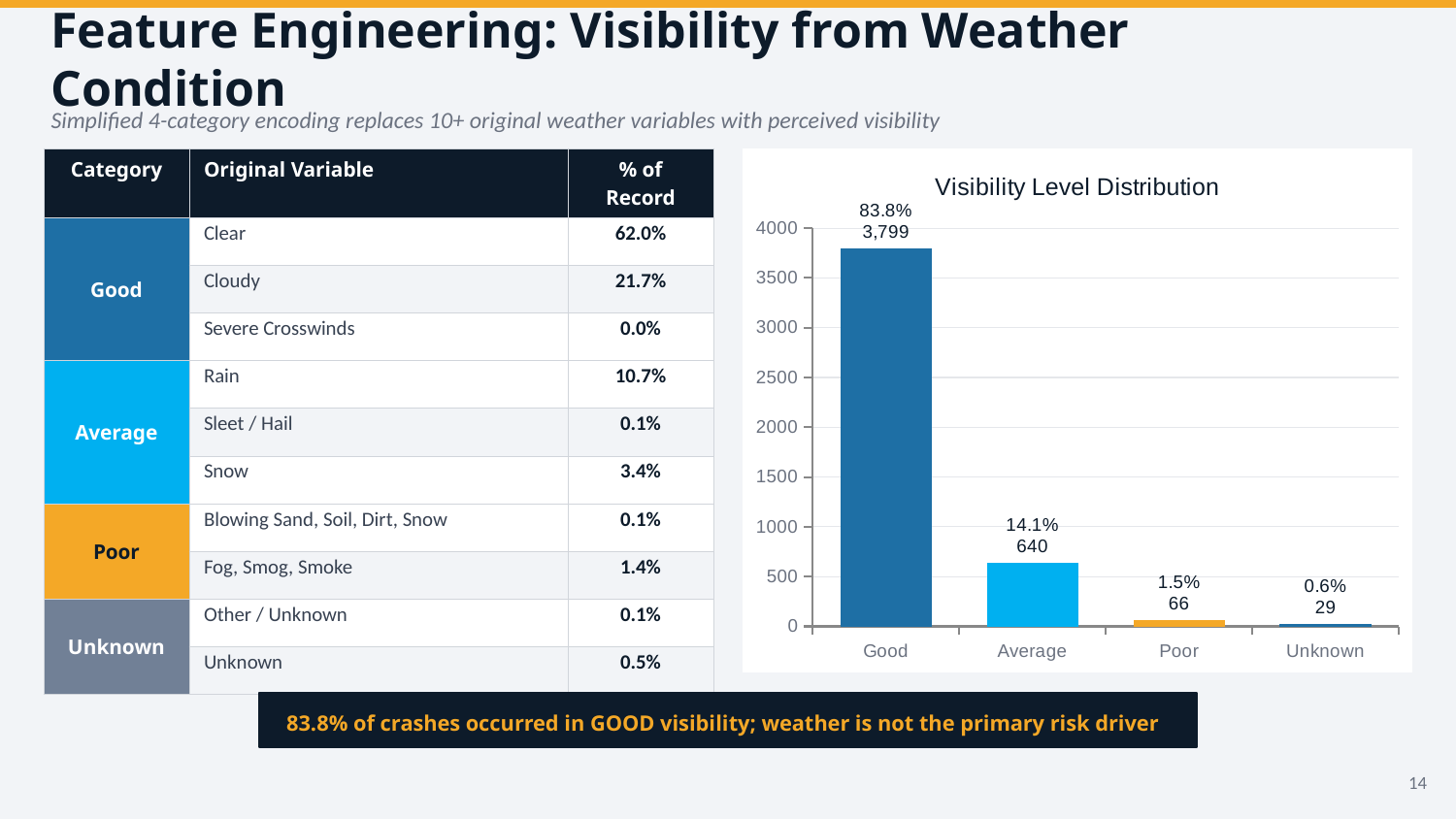
Which category has the lowest value in the Visibility Level Distribution chart? Unknown Is the value for Average in the Visibility Level Distribution chart greater or less than 500? greater What is the title of the chart on the slide? Visibility Level Distribution What is the value for Good in the Visibility Level Distribution chart? 3,799 How many categories are shown in the Visibility Level Distribution chart? 4 Which category has the highest value in the Visibility Level Distribution chart? Good What is the count shown for Unknown in the Visibility Level Distribution chart? 29 Which is larger in the Visibility Level Distribution chart, Poor or Unknown? Poor What kind of chart is the Visibility Level Distribution chart? Bar chart What is the difference between the values for Good and Average in the Visibility Level Distribution chart? 3,159 What percentage is shown for Poor in the Visibility Level Distribution chart? 1.5% What is the value for Average in the Visibility Level Distribution chart? 640